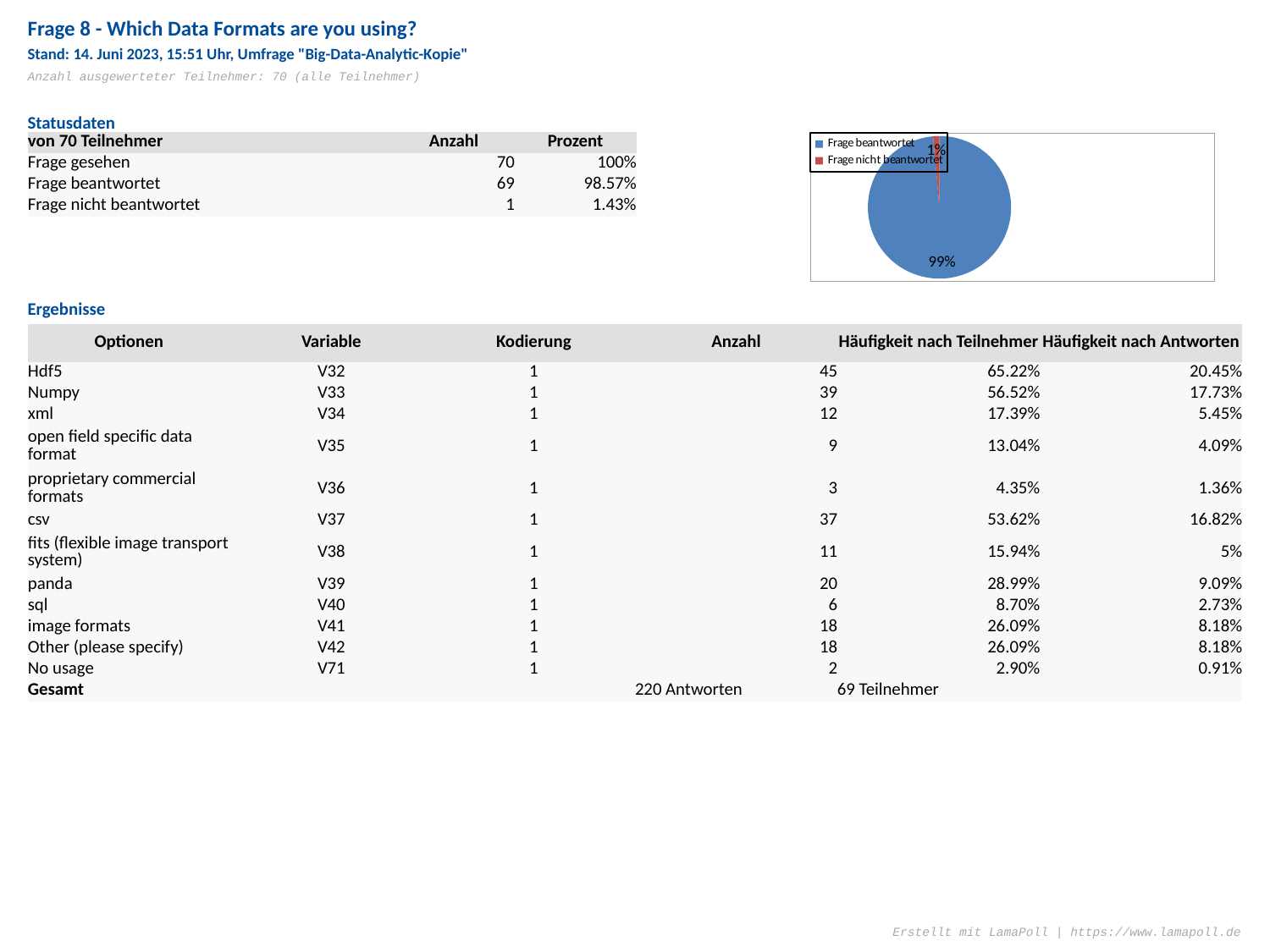
In the pie chart, which is larger: "Frage beantwortet" or "Frage nicht beantwortet"? Frage beantwortet How many entries does the pie chart's legend list? 2 What colour is the "Frage nicht beantwortet" slice in the pie chart? red What share of the pie chart does "Frage nicht beantwortet" take? 1% Which slice of the pie chart is the smallest? Frage nicht beantwortet Which slice of the pie chart is the largest? Frage beantwortet What kind of chart is shown on the slide? pie chart What share of the pie chart does "Frage beantwortet" take? 99% What is the difference in percentage points between the "Frage beantwortet" and "Frage nicht beantwortet" slices of the pie chart? 98% What colour is the "Frage beantwortet" slice in the pie chart? blue How many slices does the pie chart have? 2